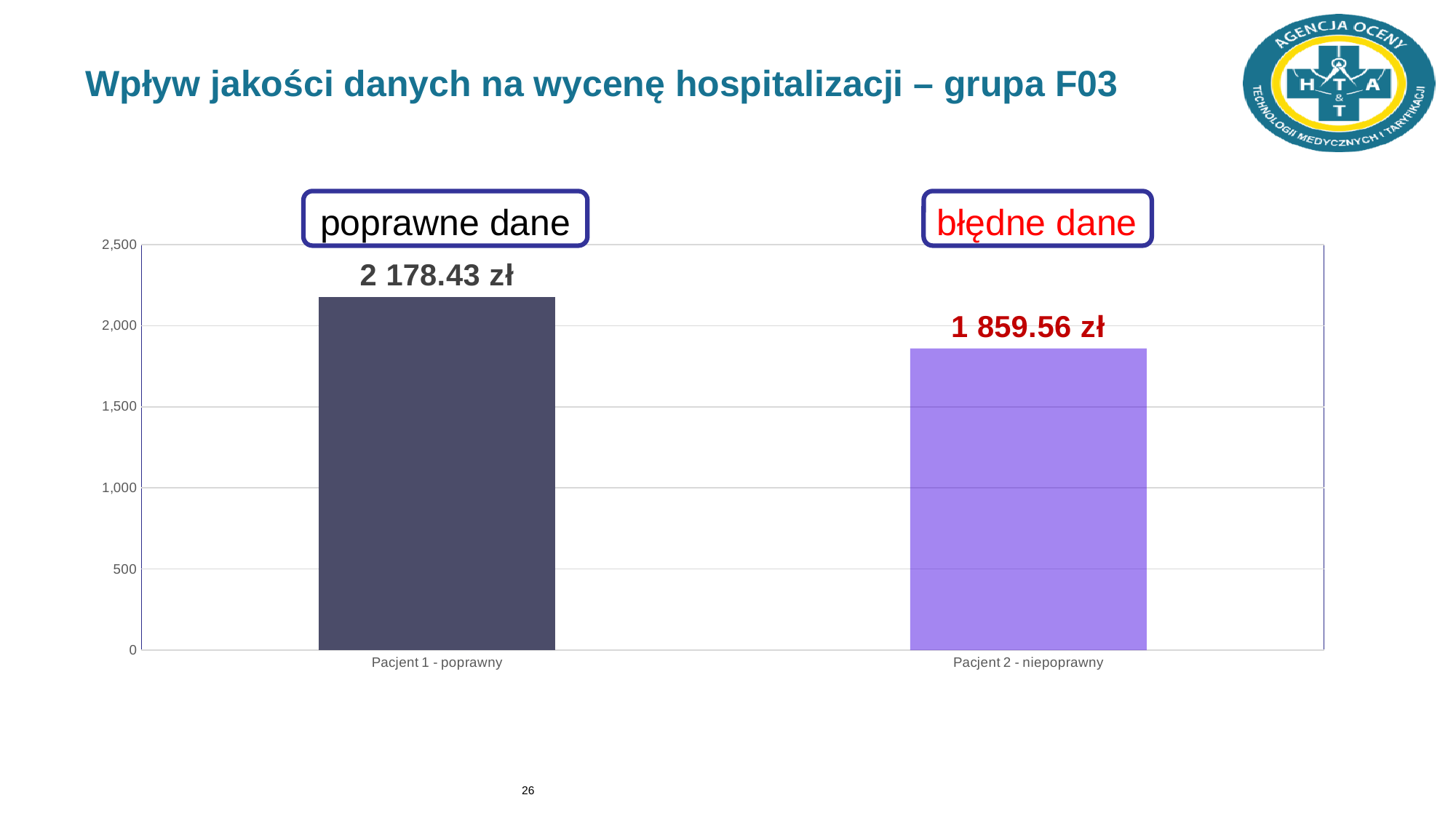
What label is shown in the box above the Pacjent 2 - niepoprawny bar? błędne dane What is the title of the slide? Wpływ jakości danych na wycenę hospitalizacji – grupa F03 What is the value for Pacjent 1 - poprawny? 2 178.43 zł What is the difference between the values for Pacjent 1 - poprawny and Pacjent 2 - niepoprawny? 318.87 zł What kind of chart is shown on the slide? bar chart Which is larger, the value for Pacjent 1 - poprawny or Pacjent 2 - niepoprawny? Pacjent 1 - poprawny Is the value for Pacjent 2 - niepoprawny greater or less than 2,000? less What is the value for Pacjent 2 - niepoprawny? 1 859.56 zł Which category has the lowest value? Pacjent 2 - niepoprawny Is the value for Pacjent 1 - poprawny greater or less than 2,000? greater How many categories are shown on the chart? 2 Which category has the highest value? Pacjent 1 - poprawny